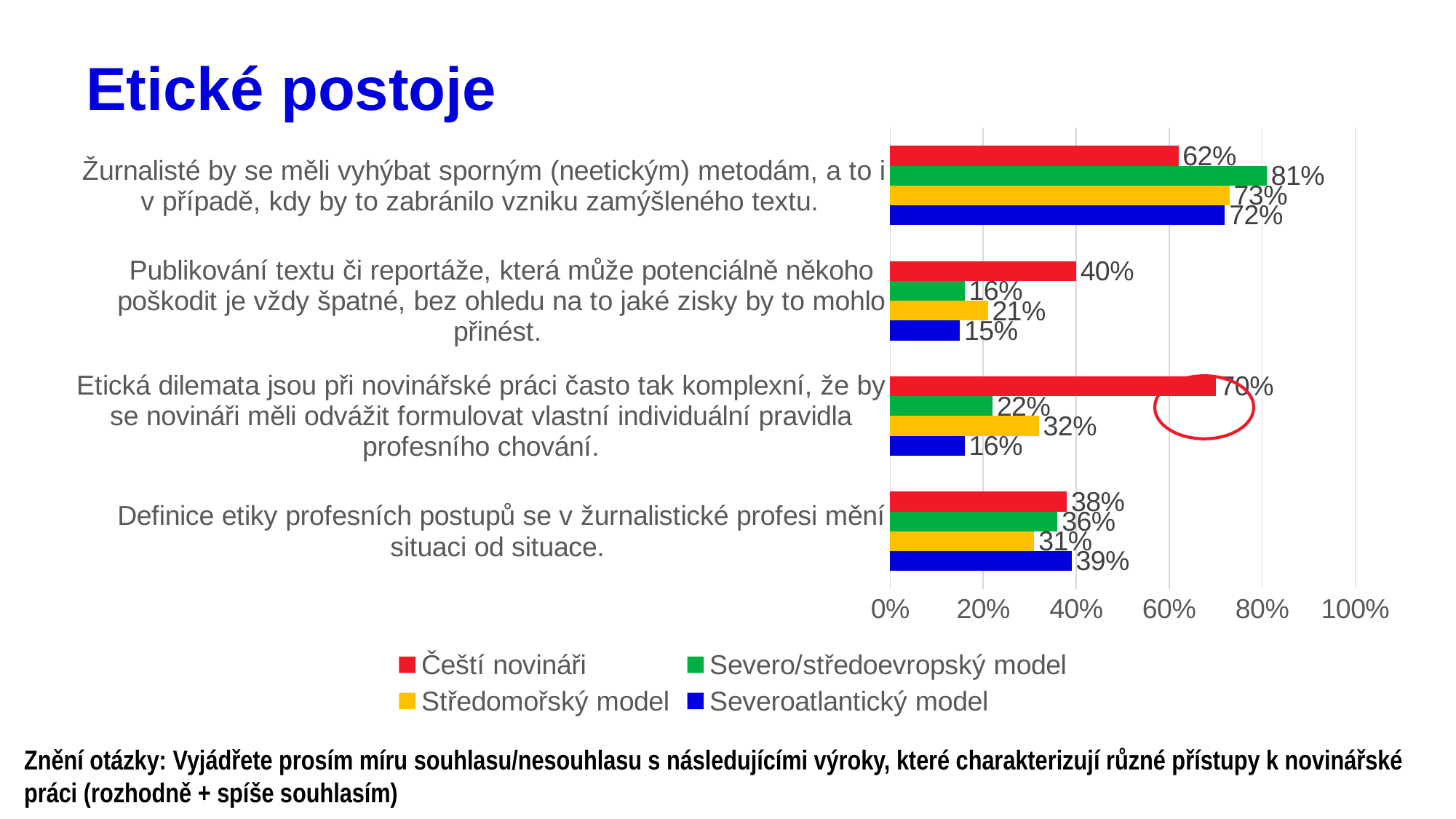
Which series has the highest value for the statement 'Definice etiky profesních postupů se v žurnalistické profesi mění situaci od situace.'? Severoatlantický model What is the value for Severoatlantický model on the statement 'Publikování textu či reportáže, která může potenciálně někoho poškodit...'? 15% What type of chart is shown on the slide? bar chart What is the value for Čeští novináři on the statement 'Etická dilemata jsou při novinářské práci často tak komplexní...'? 70% Is the value for Čeští novináři on the statement 'Žurnalisté by se měli vyhýbat sporným (neetickým) metodám...' greater or less than 60%? greater How many series does the legend list? 4 How many statements (categories) are shown on the chart? 4 What is the value for Severo/středoevropský model on the statement 'Žurnalisté by se měli vyhýbat sporným (neetickým) metodám...'? 81% What is the difference between Čeští novináři and Severo/středoevropský model on the statement 'Etická dilemata jsou při novinářské práci často tak komplexní...'? 48% Which series is shown in red in the legend? Čeští novináři On the statement 'Publikování textu či reportáže...', which is larger: Středomořský model or Severo/středoevropský model? Středomořský model Which series has the lowest value for the statement 'Etická dilemata jsou při novinářské práci často tak komplexní...'? Severoatlantický model